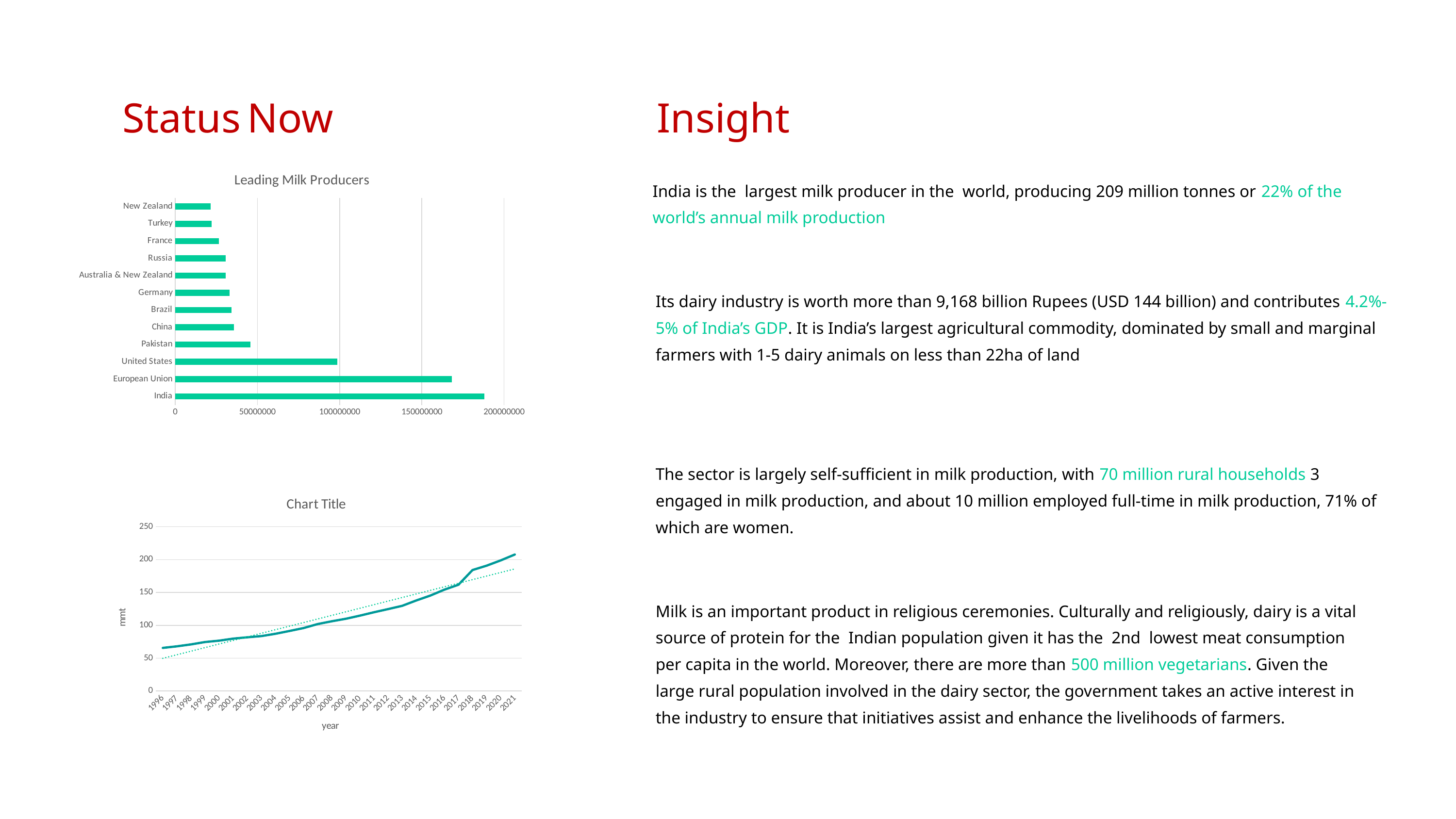
How many producers are shown in the 'Leading Milk Producers' chart? 12 In the chart titled 'Chart Title', is the value for 2021 greater or less than 200? greater What is the y-axis label of the chart titled 'Chart Title'? mmt In the 'Leading Milk Producers' chart, is the value for Pakistan greater or less than 50000000? less In the chart titled 'Chart Title', do the values rise or fall from 1996 to 2021? rise In the 'Leading Milk Producers' chart, which producer has the highest value? India What kind of chart is the 'Leading Milk Producers' chart? bar chart What kind of chart is the chart titled 'Chart Title' at the bottom left? line chart In the 'Leading Milk Producers' chart, which is larger, Pakistan or China? Pakistan In the 'Leading Milk Producers' chart, is the value for India greater or less than 150000000? greater In the 'Leading Milk Producers' chart, which is larger, European Union or United States? European Union